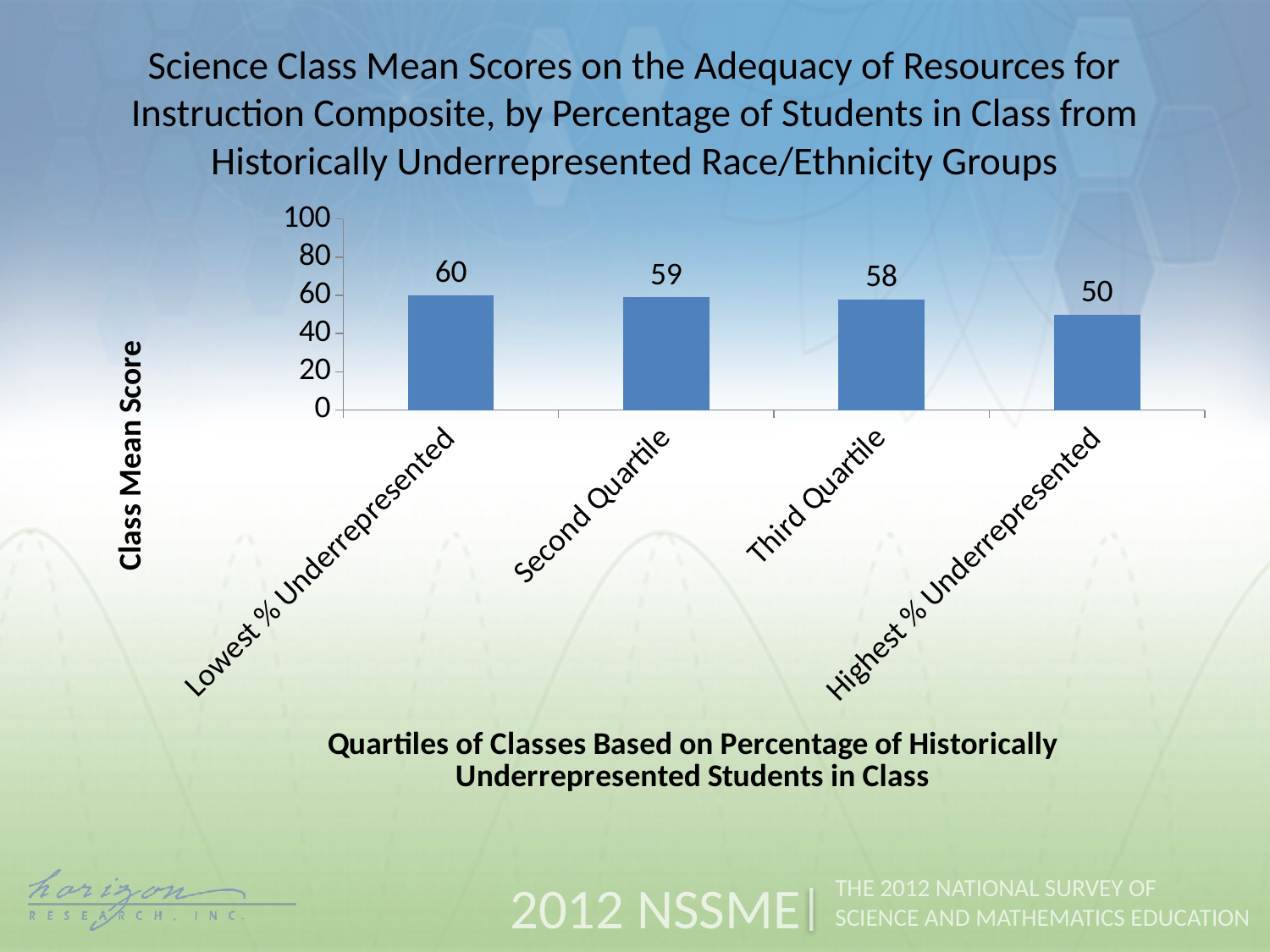
What is the class mean score for the Lowest % Underrepresented quartile? 60 How many quartile categories are shown in the chart? 4 What is the class mean score for the Second Quartile? 59 What is the class mean score for the Highest % Underrepresented quartile? 50 What is the difference between the class mean scores of the Lowest % Underrepresented and Highest % Underrepresented quartiles? 10 What is the label of the vertical axis? Class Mean Score What kind of chart is shown on the slide? Bar chart Which quartile has the highest class mean score? Lowest % Underrepresented What is the class mean score for the Third Quartile? 58 Do the class mean scores rise or fall moving from the Lowest % Underrepresented quartile to the Highest % Underrepresented quartile? Fall Which quartile has the lowest class mean score? Highest % Underrepresented Which has a larger class mean score, the Third Quartile or the Highest % Underrepresented quartile? Third Quartile